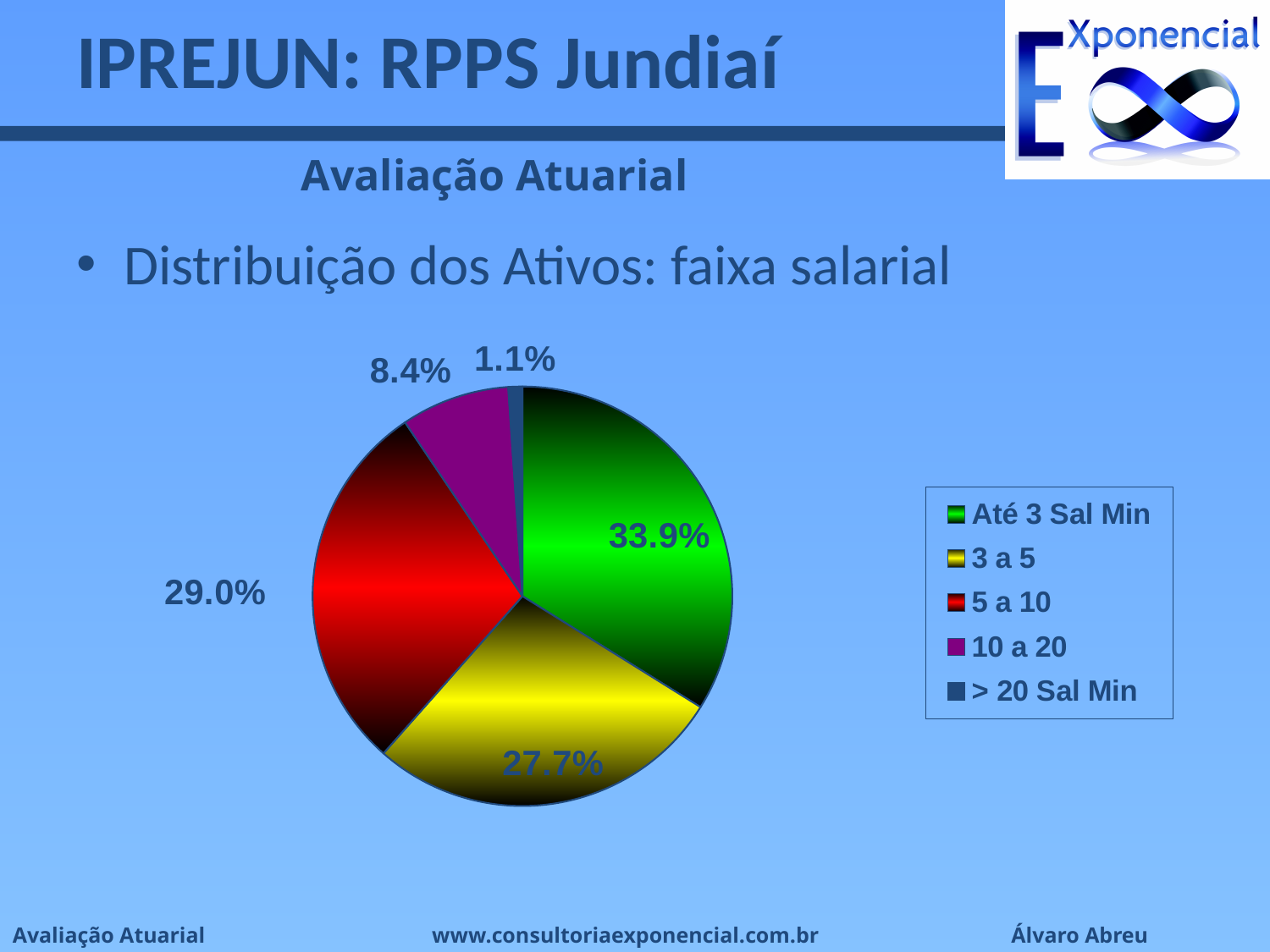
Which category has the smallest slice of the pie? > 20 Sal Min What kind of chart is shown on the slide? pie chart What colour is the '10 a 20' slice? purple Which category has the largest slice of the pie? Até 3 Sal Min What is the value shown for the '5 a 10' slice? 29.0% Which is larger, the '5 a 10' slice or the '3 a 5' slice? 5 a 10 What is the difference in percentage points between the 'Até 3 Sal Min' slice and the '3 a 5' slice? 6.2 What is the value shown for the '> 20 Sal Min' slice? 1.1% How many categories does the legend list? 5 What share of the pie does the 'Até 3 Sal Min' slice represent? 33.9% What is the value shown for the '3 a 5' slice? 27.7% What is the value shown for the '10 a 20' slice? 8.4%